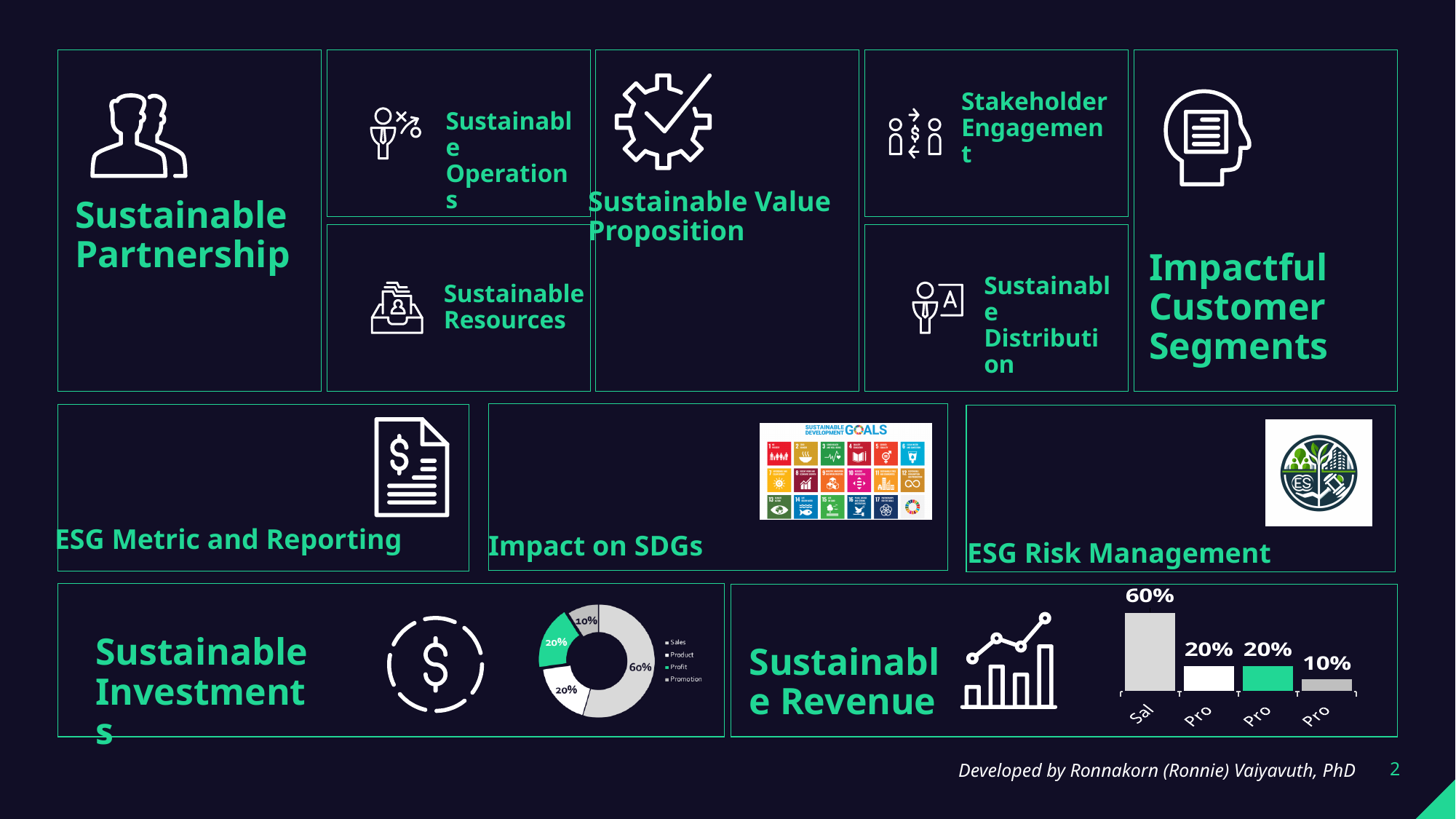
In the donut chart in the Sustainable Investments box, what is the smallest slice's share? 10% In the bar chart in the Sustainable Revenue box, do the values rise or fall from left to right? Fall In the donut chart in the Sustainable Investments box, what is the largest slice's share? 60% What kind of chart is shown in the Sustainable Revenue box? Bar chart How many bars are in the bar chart in the Sustainable Revenue box? 4 In the bar chart in the Sustainable Revenue box, what is the value of the last bar? 10% What kind of chart is shown in the Sustainable Investments box? Donut (pie) chart In the bar chart in the Sustainable Revenue box, what is the value of the green bar? 20% In the bar chart in the Sustainable Revenue box, what is the difference between the first bar (60%) and the last bar (10%)? 50% In the bar chart in the Sustainable Revenue box, what is the value of the first (tallest) bar? 60% In the donut chart in the Sustainable Investments box, what share does the green Profit slice have? 20% How many entries does the legend of the donut chart in the Sustainable Investments box list? 4